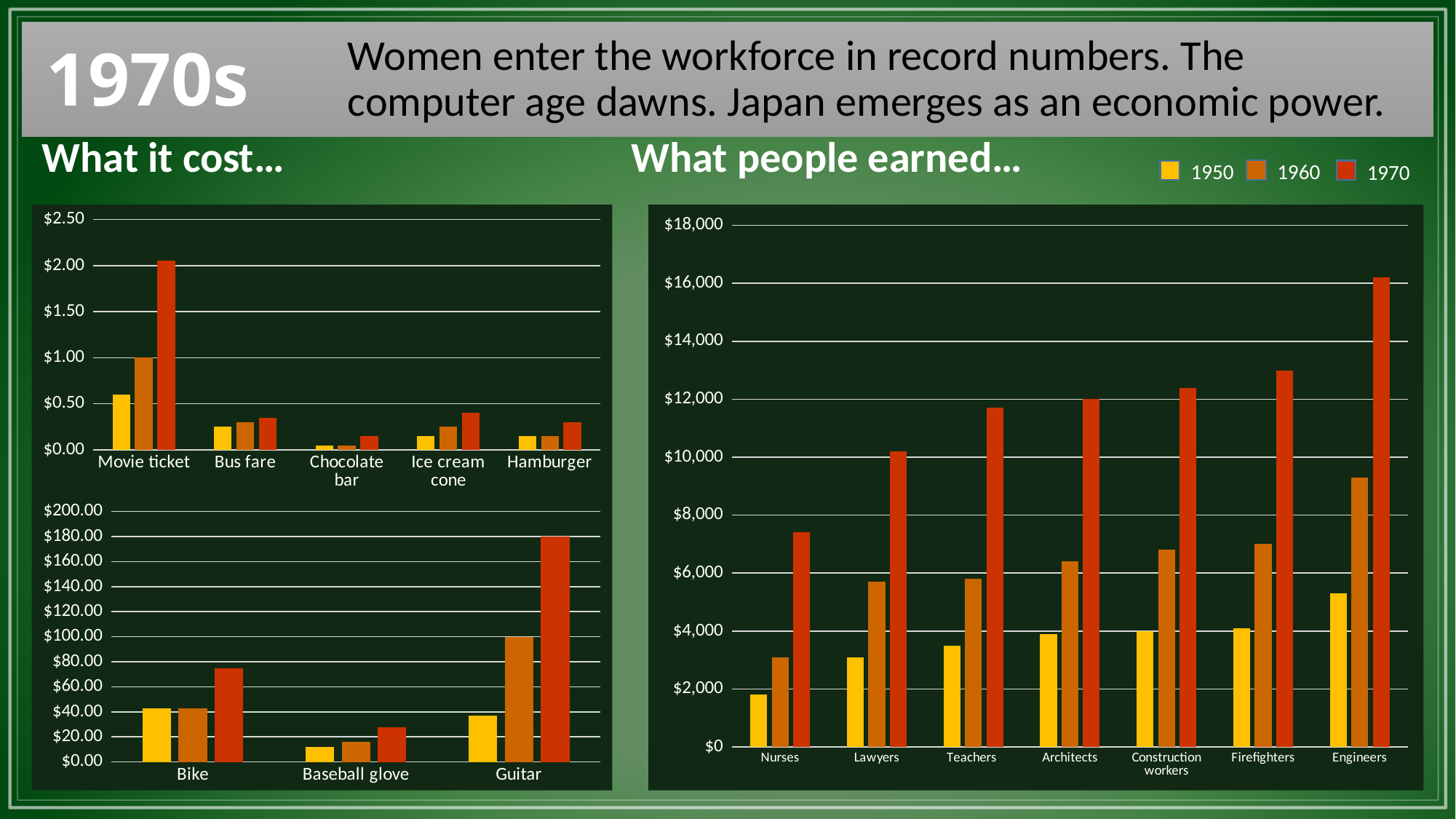
On the 'What people earned...' chart, is the 1970 value for Nurses greater or less than $8,000? less On the bottom-left 'What it cost...' chart, is the 1970 value for Bike greater or less than $60.00? greater On the 'What people earned...' chart, do the 1970 values rise or fall moving from Nurses on the left to Engineers on the right? rise On the 'What people earned...' chart, which bar is the lowest overall? Nurses, 1950 On the 'What people earned...' chart, which is larger: the 1970 value for Lawyers or the 1970 value for Teachers? Teachers On the top-left 'What it cost...' chart, which item has the tallest bar? Movie ticket What kind of chart is the bottom-left chart showing Bike, Baseball glove and Guitar? bar chart How many series does the legend at the top right of the slide list? 3 On the 'What people earned...' chart, which occupation has the tallest bar for 1970? Engineers On the top-left 'What it cost...' chart, is the 1970 value for Movie ticket greater or less than $1.50? greater How many occupations are shown on the 'What people earned...' chart? 7